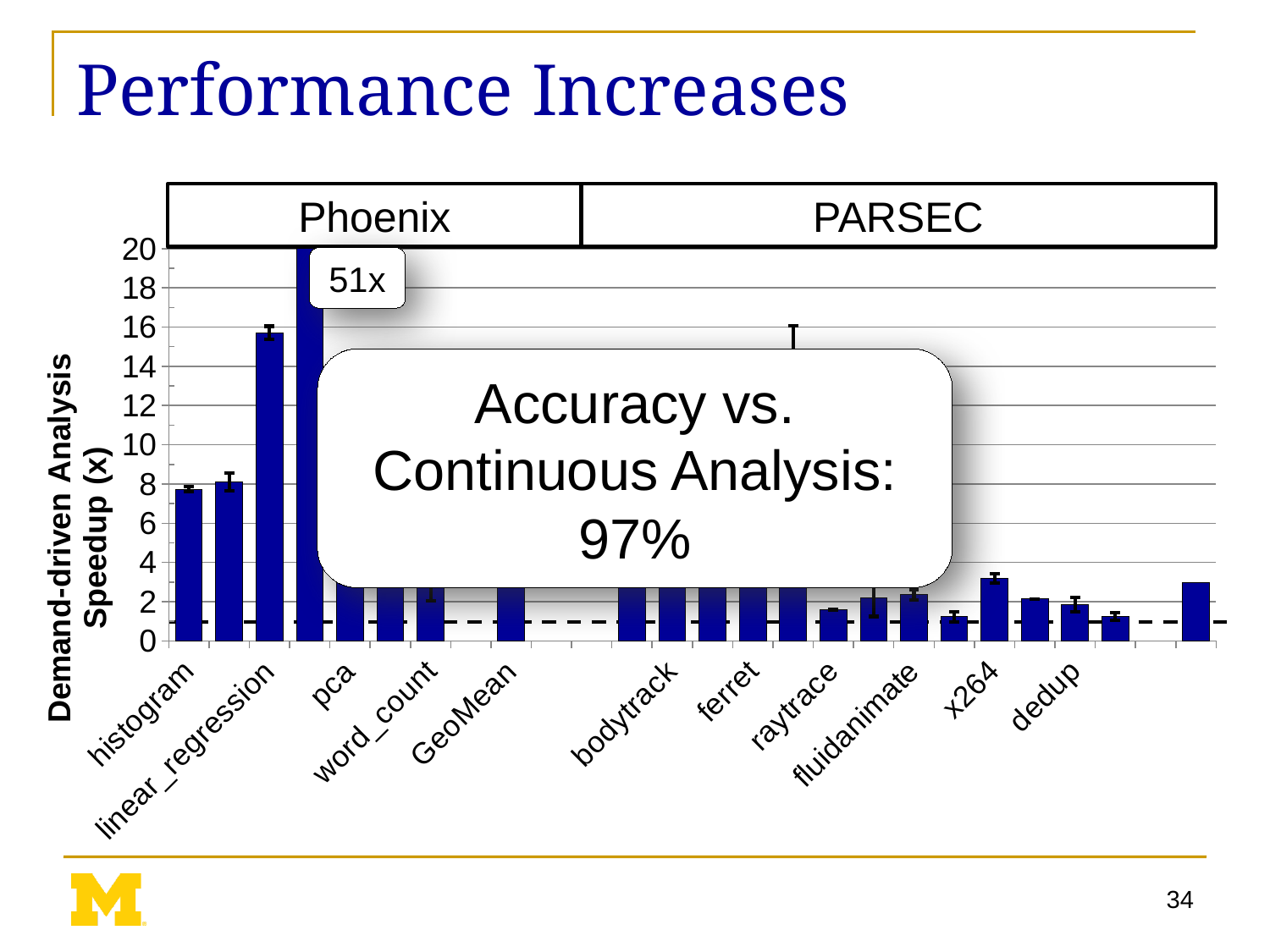
Which benchmark suite group contains the bar labelled 51x? Phoenix What is the highest tick value shown on the y axis? 20 What accuracy versus continuous analysis is stated in the callout over the chart? 97% Is the value for linear_regression greater or less than 6? greater Is the value for histogram greater or less than 10? less What are the two benchmark suite headings shown above the chart? Phoenix and PARSEC What value is annotated on the tallest bar, which extends above the top of the axis? 51x What kind of chart is shown on the slide? bar chart Is the value for histogram greater or less than 6? greater What is the label of the y axis? Demand-driven Analysis Speedup (x)